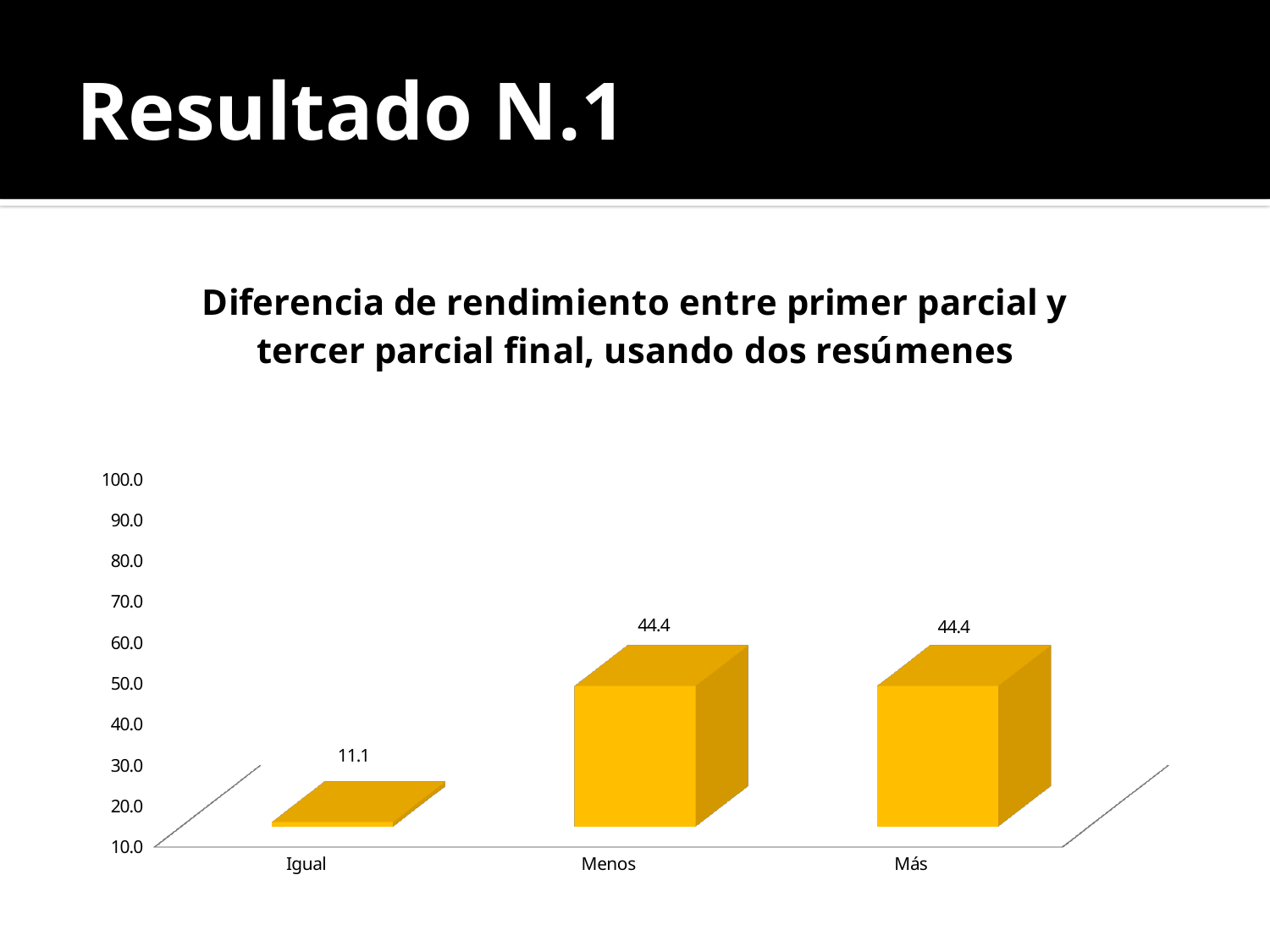
What kind of chart is shown on the slide? bar chart Which category has the lowest value? Igual Which is larger, the value for Igual or the value for Más? Más Is the value for Igual greater or less than 20.0? less What is the title of the chart? Diferencia de rendimiento entre primer parcial y tercer parcial final, usando dos resúmenes What is the value for Igual? 11.1 What is the highest value shown on the vertical axis? 100.0 What is the value for Más? 44.4 How many categories are shown on the x axis? 3 Is the value for Menos greater or less than 30.0? greater What is the difference between the values for Menos and Igual? 33.3 What is the value for Menos? 44.4